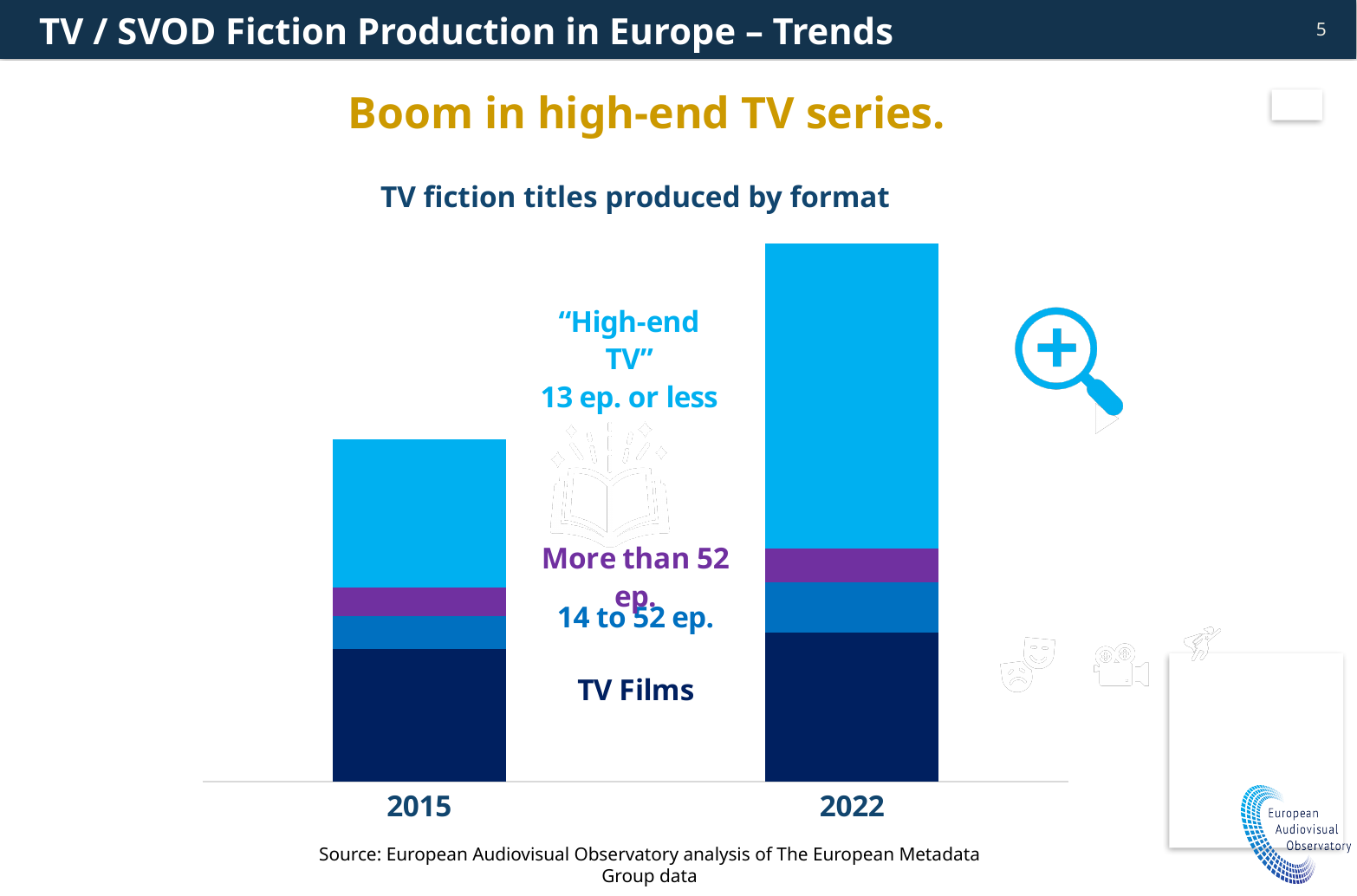
What kind of chart is shown on the slide? Bar chart Which format is labelled as "High-end TV" on the chart? 13 ep. or less Which format segment is at the bottom of each stacked bar? TV Films Which format segment is the largest in the 2022 bar? 13 ep. or less What is the title of the chart? TV fiction titles produced by format Does the total number of TV fiction titles rise or fall from 2015 to 2022? Rise How many format segments make up each stacked bar? 4 Which year has the taller stacked bar, 2015 or 2022? 2022 How many years are shown on the x axis of the chart? 2 Is the '13 ep. or less' segment larger in 2015 or in 2022? 2022